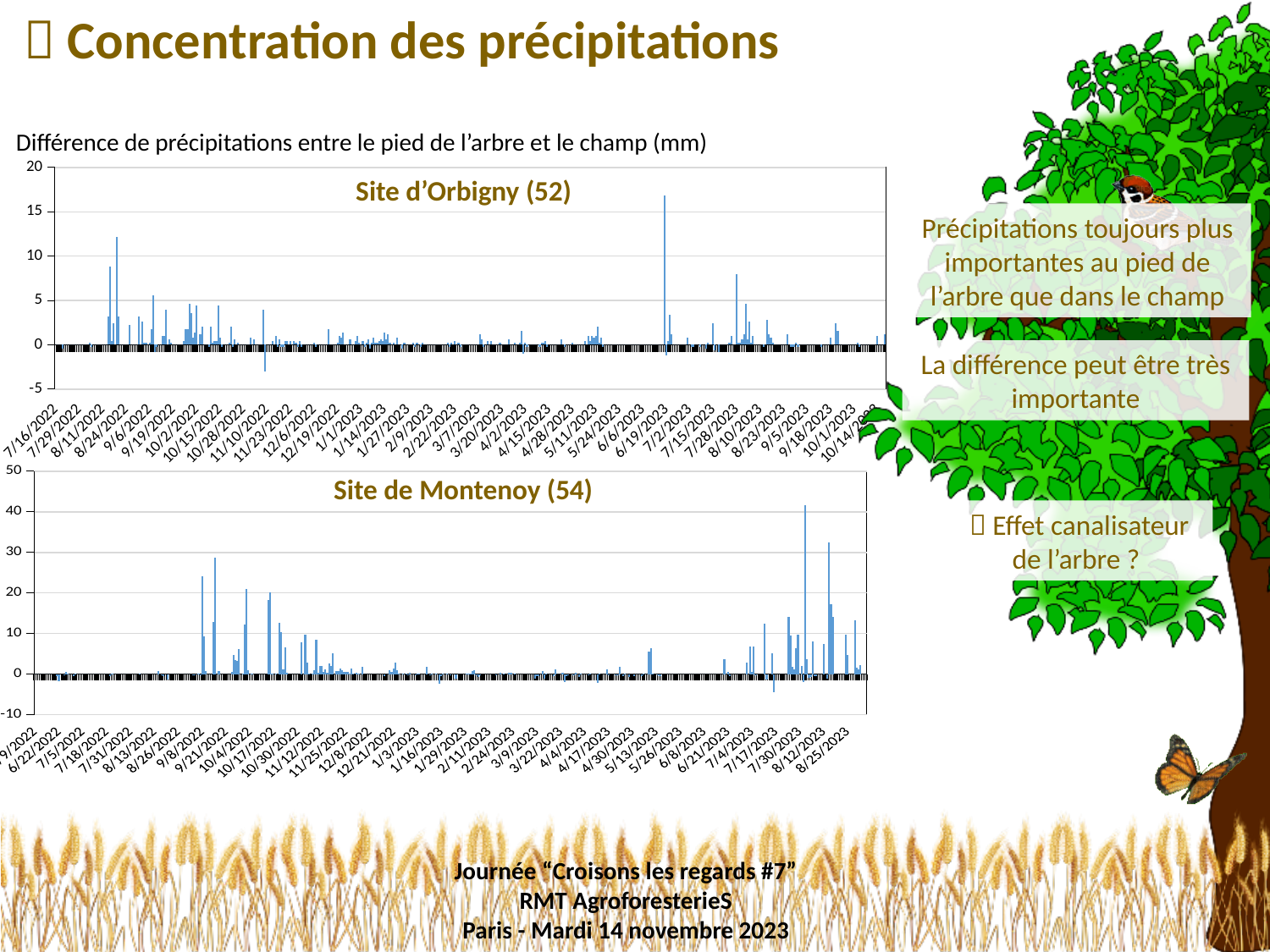
In the 'Site d'Orbigny (52)' chart, is the lowest (most negative) bar greater or less than -5? greater What is the title of the bottom chart? Site de Montenoy (54) How many charts are shown on the slide? 2 What is the title of the top chart? Site d'Orbigny (52) In the 'Site de Montenoy (54)' chart, is the highest bar greater or less than 30? greater What is the maximum value shown on the y-axis of the 'Site d'Orbigny (52)' chart? 20 What kind of chart is the 'Site de Montenoy (54)' chart? bar chart What kind of chart is the 'Site d'Orbigny (52)' chart? bar chart Which chart has the higher peak value, 'Site d'Orbigny (52)' or 'Site de Montenoy (54)'? Site de Montenoy (54) In the 'Site de Montenoy (54)' chart, is the highest bar in the second half of 2022 (around 9/21/2022) greater or less than 20? greater